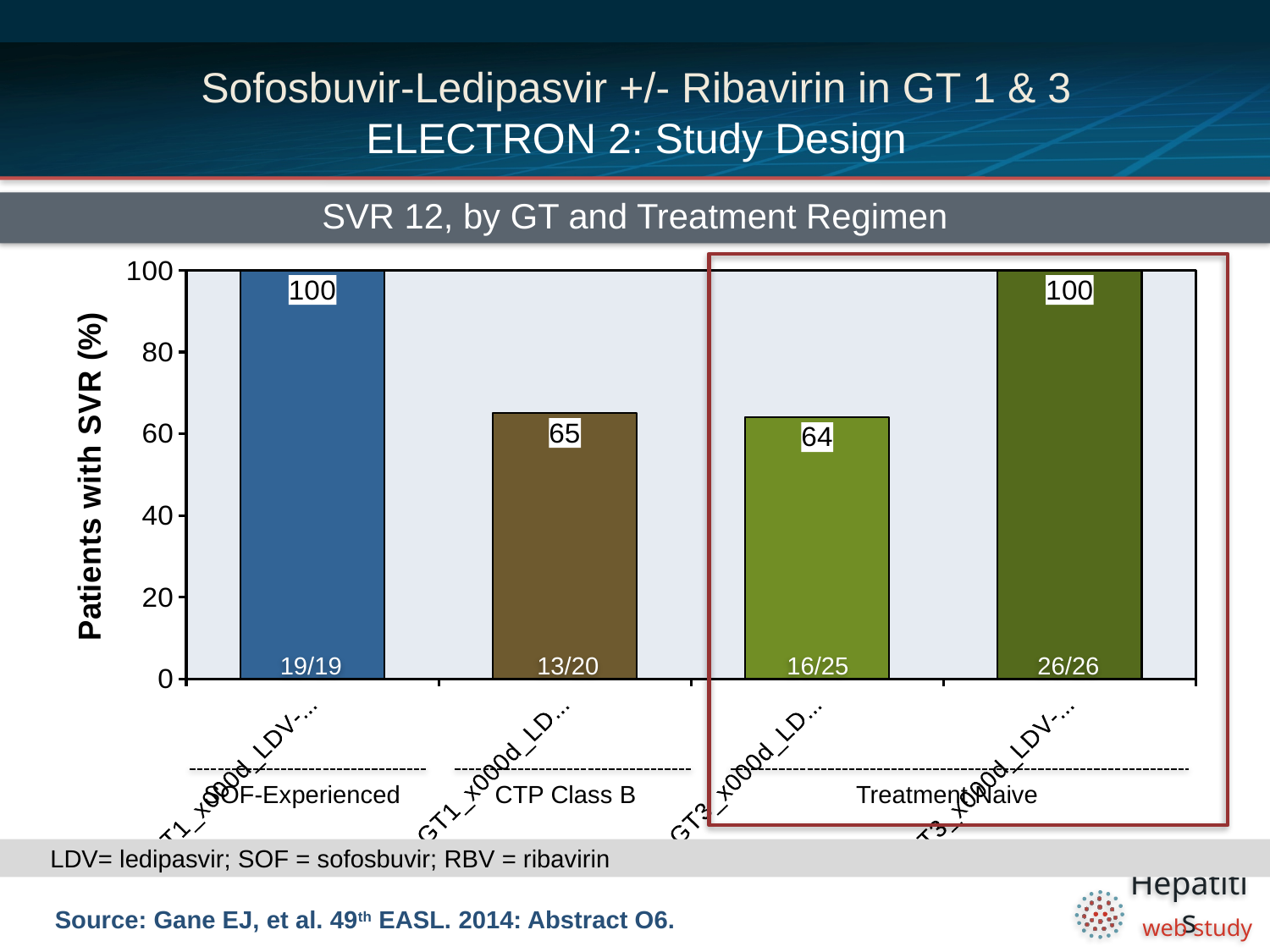
How many bars are plotted in the chart? 4 What is the value of the second (right) bar in the Treatment Naive group? 100 What is the SVR value (%) for the CTP Class B bar? 65 What is the difference between the SOF-Experienced value and the CTP Class B value? 35 What is the SVR value (%) for the SOF-Experienced bar? 100 What is the title of the chart? SVR 12, by GT and Treatment Regimen What is the label of the y-axis? Patients with SVR (%) What is the value of the first (left) bar in the Treatment Naive group? 64 What is the lowest SVR value shown in the chart? 64 What type of chart is shown on the slide? bar chart What patient fraction is printed on the SOF-Experienced bar? 19/19 What patient fraction is printed on the CTP Class B bar? 13/20